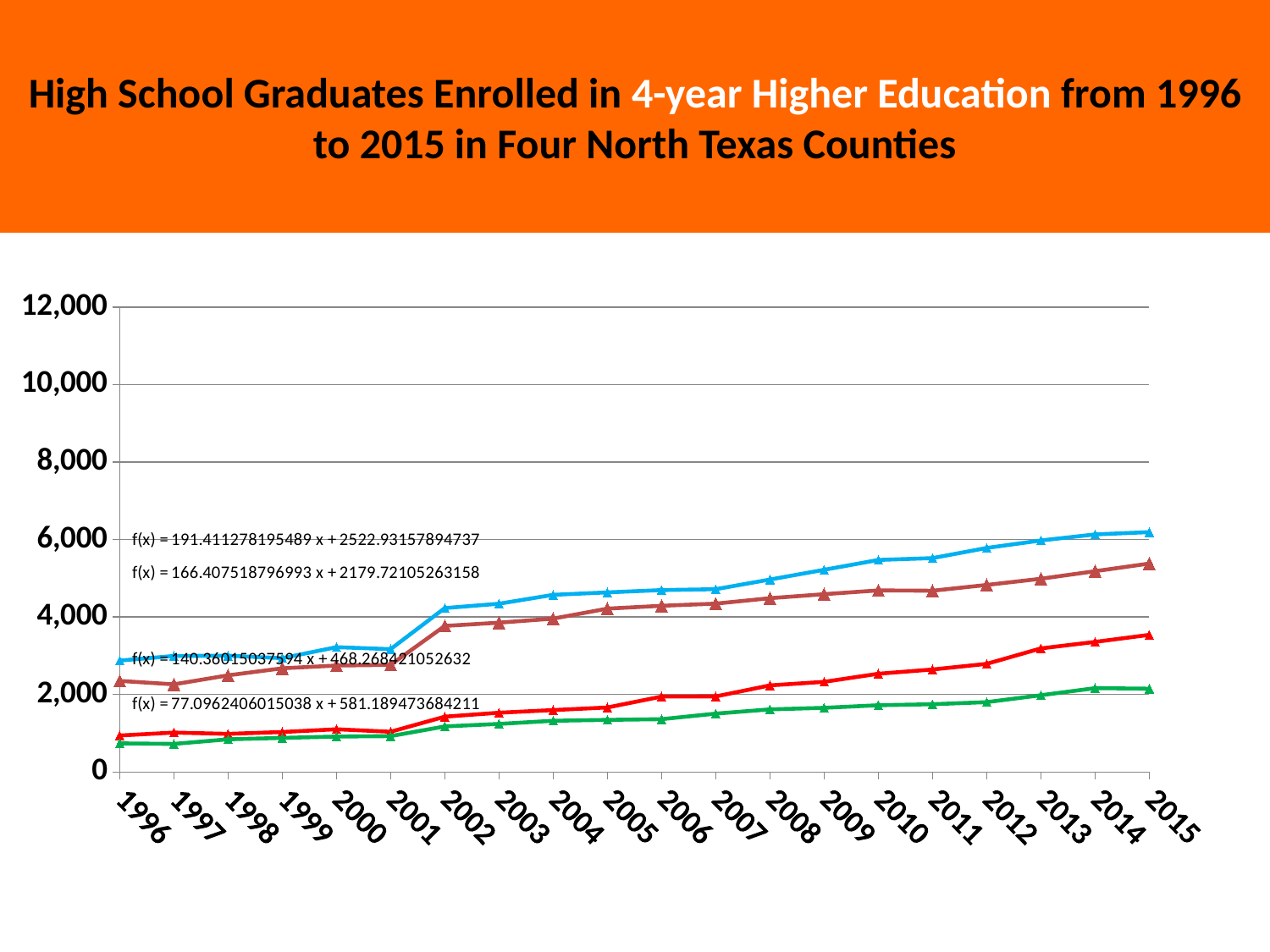
Which line has the lowest value in 2015? the green line What is the title of the slide? High School Graduates Enrolled in 4-year Higher Education from 1996 to 2015 in Four North Texas Counties Is the value of the red line in 2015 greater or less than 3,000? greater How many years are plotted along the x axis? 20 What kind of chart is shown on the slide? line chart Is the value of the green line in 1996 greater or less than 1,000? less How many lines are plotted on the chart? 4 Is the value of the blue line in 2015 greater or less than 5,000? greater Does the blue line rise or fall overall from 1996 to 2015? rise What is the highest value shown on the y axis? 12,000 Which line has the highest value in 2015? the blue line In 2015, which is larger: the value of the brown line or the value of the red line? the brown line